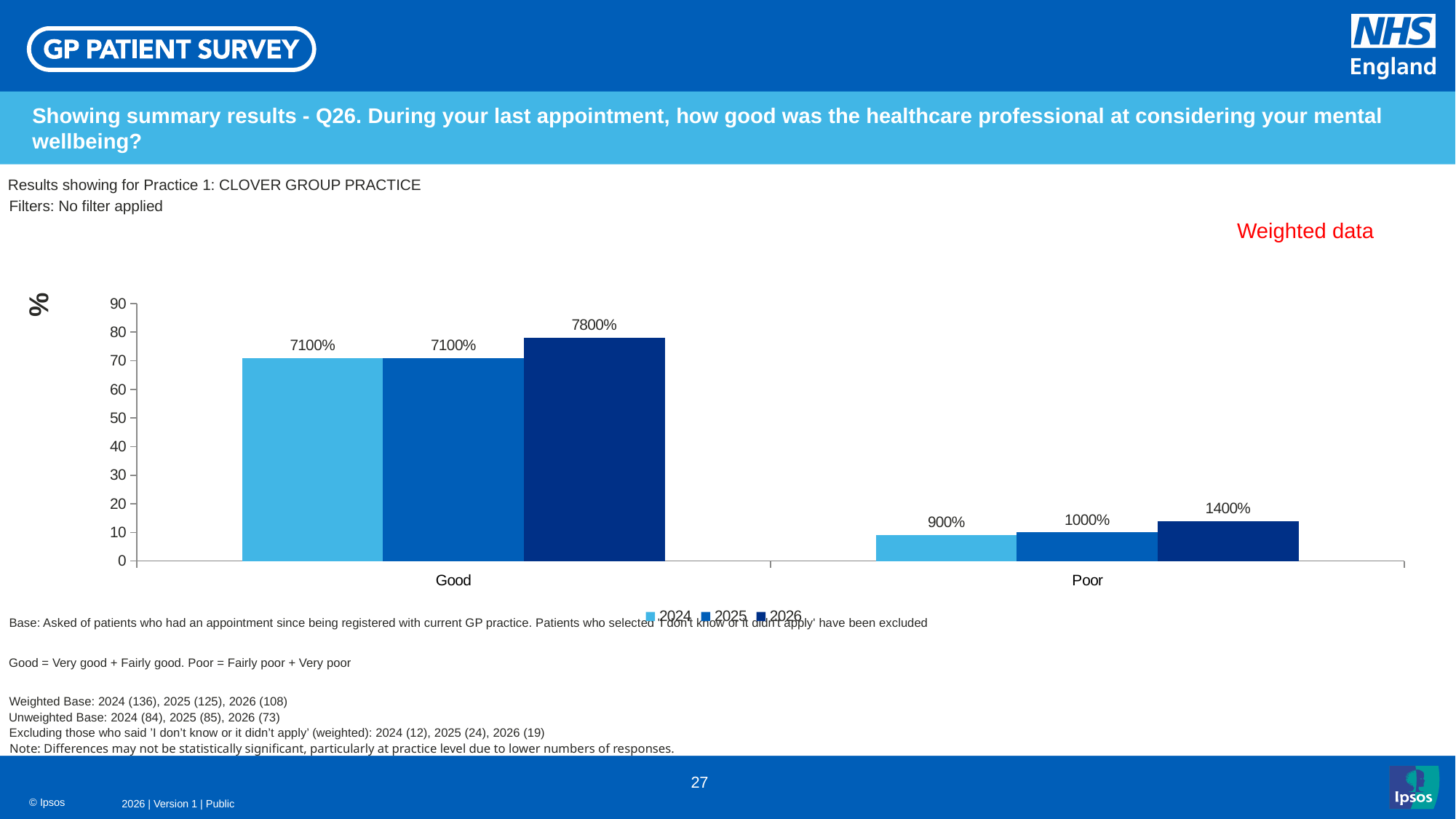
What is the data label shown for the 2025 series in the Poor category? 1000% What is the data label shown for the 2024 series in the Good category? 7100% Which category, Good or Poor, has the taller bars? Good What is the data label shown for the 2026 series in the Good category? 7800% Which year has the lowest bar in the Poor category? 2024 What kind of chart is shown on the slide? Bar chart Which year has the highest bar in the Poor category? 2026 Is the 2026 bar for Poor greater or less than 20 on the axis? less How many categories are shown on the x axis? 2 What is the data label shown for the 2024 series in the Poor category? 900% Is the 2026 bar for Good greater or less than 70 on the axis? greater How many series does the legend list? 3